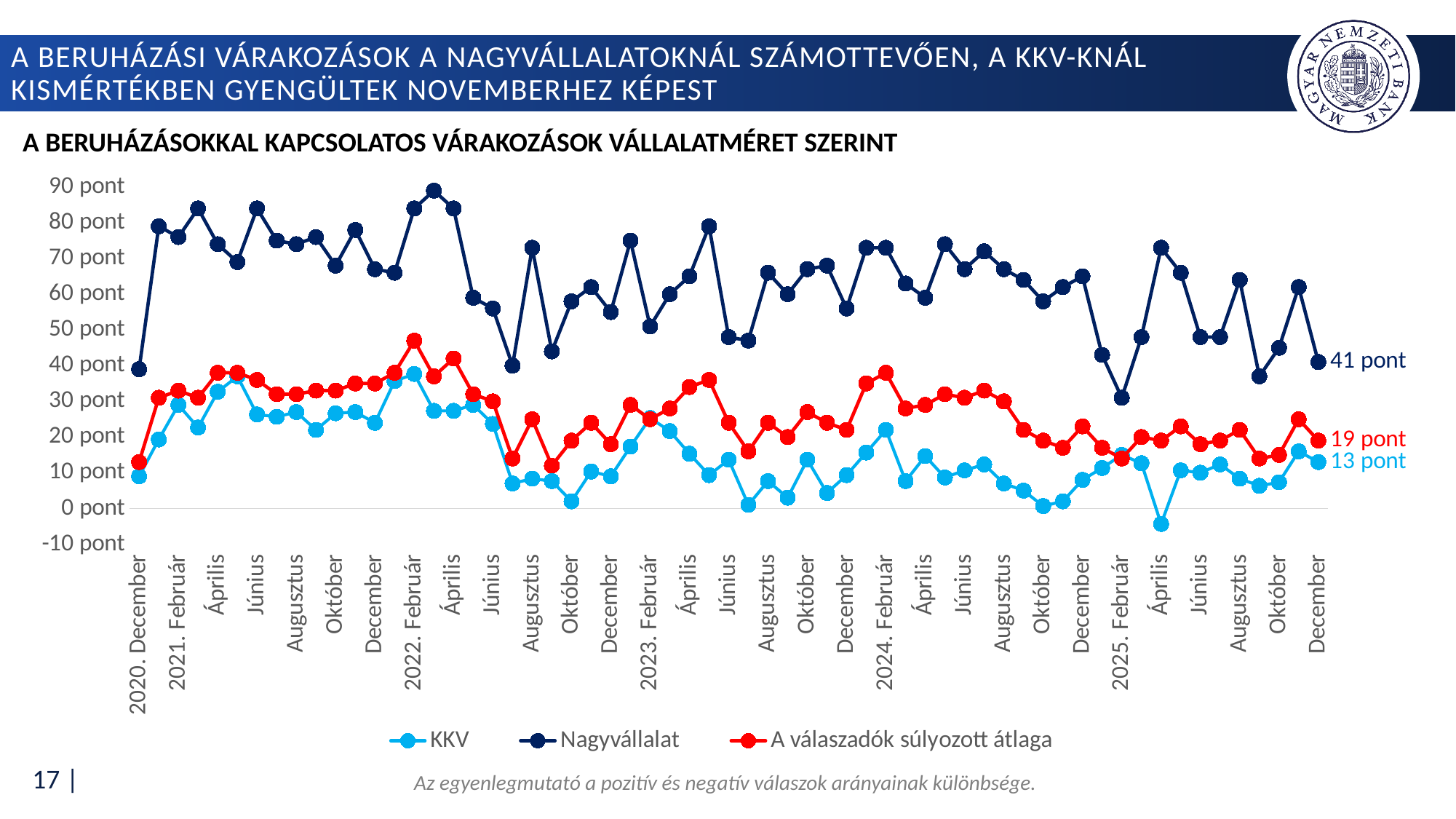
What is the value for KKV at the last point (2025 December)? 13 pont Is the value for KKV in 2025 Április greater or less than 0 pont? less Which series has the highest value at the last point (2025 December)? Nagyvállalat What kind of chart is shown on the slide? Line chart How many series does the legend list? 3 What is the difference between the Nagyvállalat value and A válaszadók súlyozott átlaga at the last point (2025 December)? 22 pont What is the value for Nagyvállalat at the last point (2025 December)? 41 pont At the last point (2025 December), which is larger: the KKV value or the Nagyvállalat value? Nagyvállalat What is the difference between the Nagyvállalat and KKV values at the last point (2025 December)? 28 pont Which series has the lowest value at the last point (2025 December)? KKV What is the value for A válaszadók súlyozott átlaga at the last point (2025 December)? 19 pont Is the value for Nagyvállalat in 2025 Február greater or less than 40 pont? less